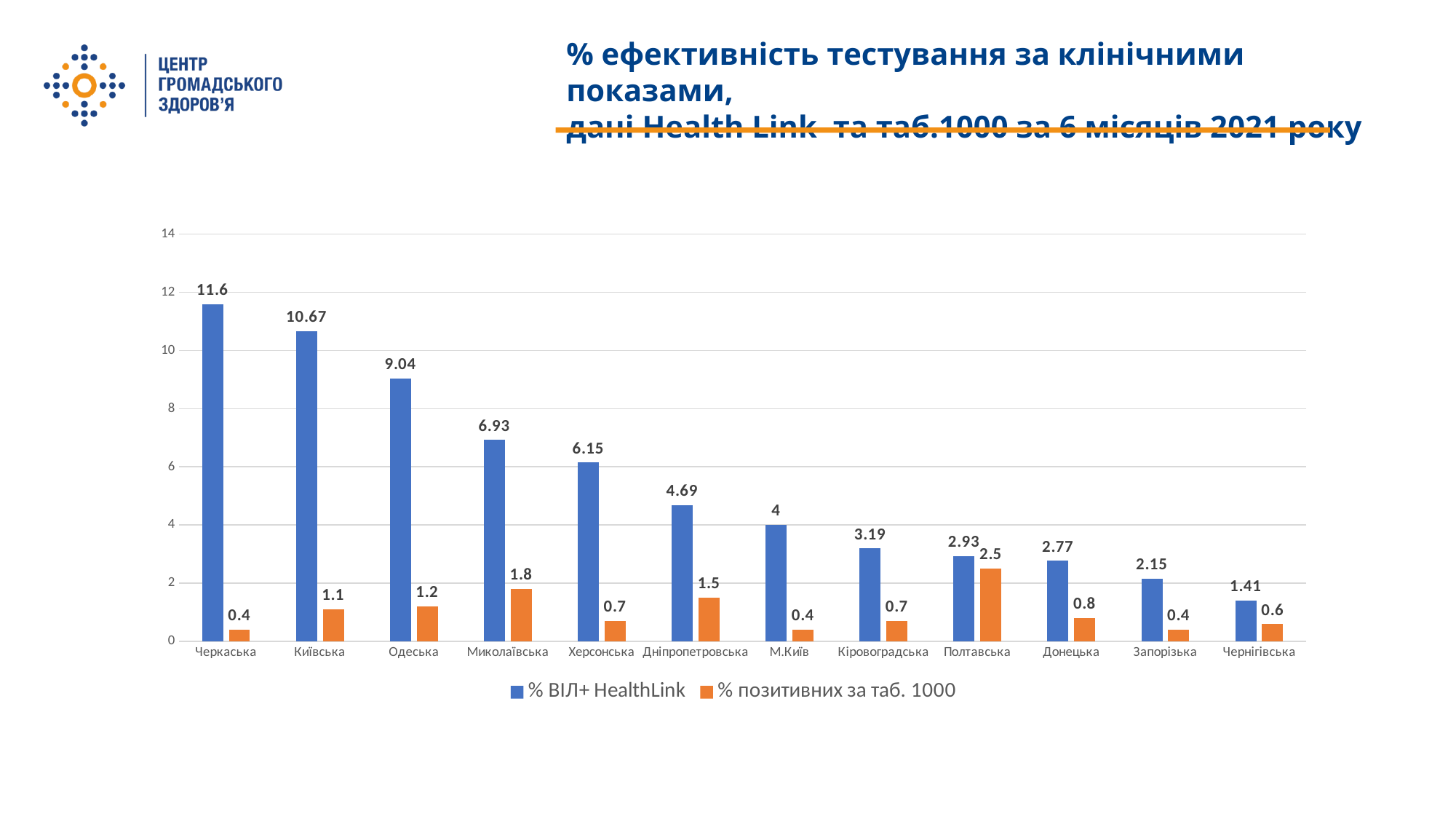
How many regions are shown on the x axis? 12 What is the % позитивних за таб. 1000 value for Полтавська? 2.5 What kind of chart is shown on the slide? Bar chart Which region has the lowest % ВІЛ+ HealthLink value? Чернігівська Which region has the highest % позитивних за таб. 1000 value? Полтавська Which is larger for Миколаївська: the % ВІЛ+ HealthLink value or the % позитивних за таб. 1000 value? % ВІЛ+ HealthLink What is the difference between the % ВІЛ+ HealthLink values for Київська and Одеська? 1.63 How many series does the legend list? 2 What is the % ВІЛ+ HealthLink value for Дніпропетровська? 4.69 What is the % ВІЛ+ HealthLink value for Черкаська? 11.6 Which region has the highest % ВІЛ+ HealthLink value? Черкаська Do the % ВІЛ+ HealthLink values rise or fall from left to right along the x axis? Fall